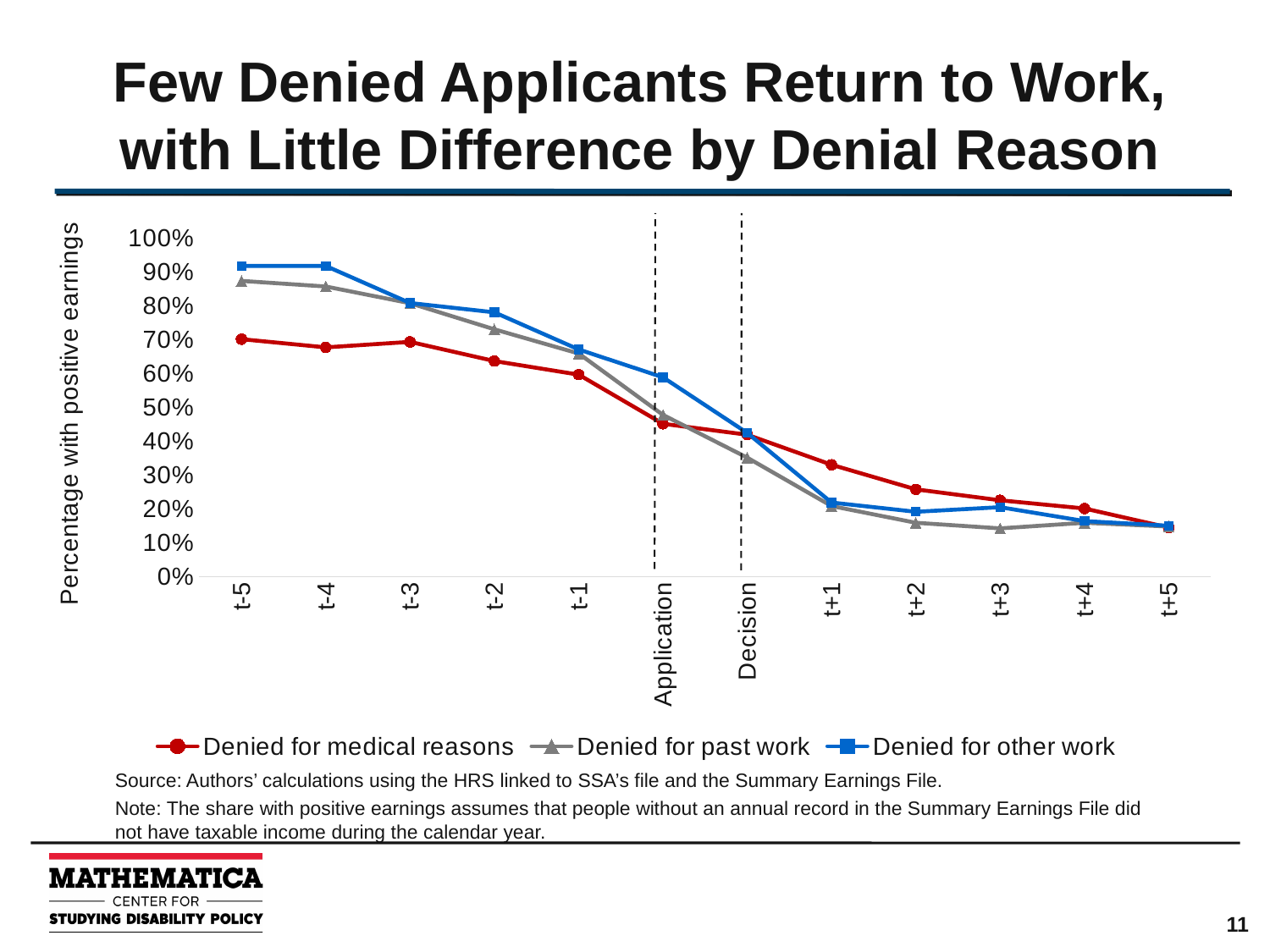
What is the label on the vertical axis? Percentage with positive earnings How many points are plotted along the x axis for each series? 12 Is the value for 'Denied for past work' at t+3 greater or less than 20%? less Does the 'Denied for medical reasons' series rise or fall from t-5 to t+5? Fall Is the value for 'Denied for medical reasons' at t-5 greater or less than 80%? less At t+1, which is larger: 'Denied for medical reasons' or 'Denied for past work'? Denied for medical reasons How many series does the legend list? 3 What kind of chart is shown on the slide? Line chart Is the value for 'Denied for other work' at t-5 greater or less than 80%? greater At t-5, which series has the highest value? Denied for other work